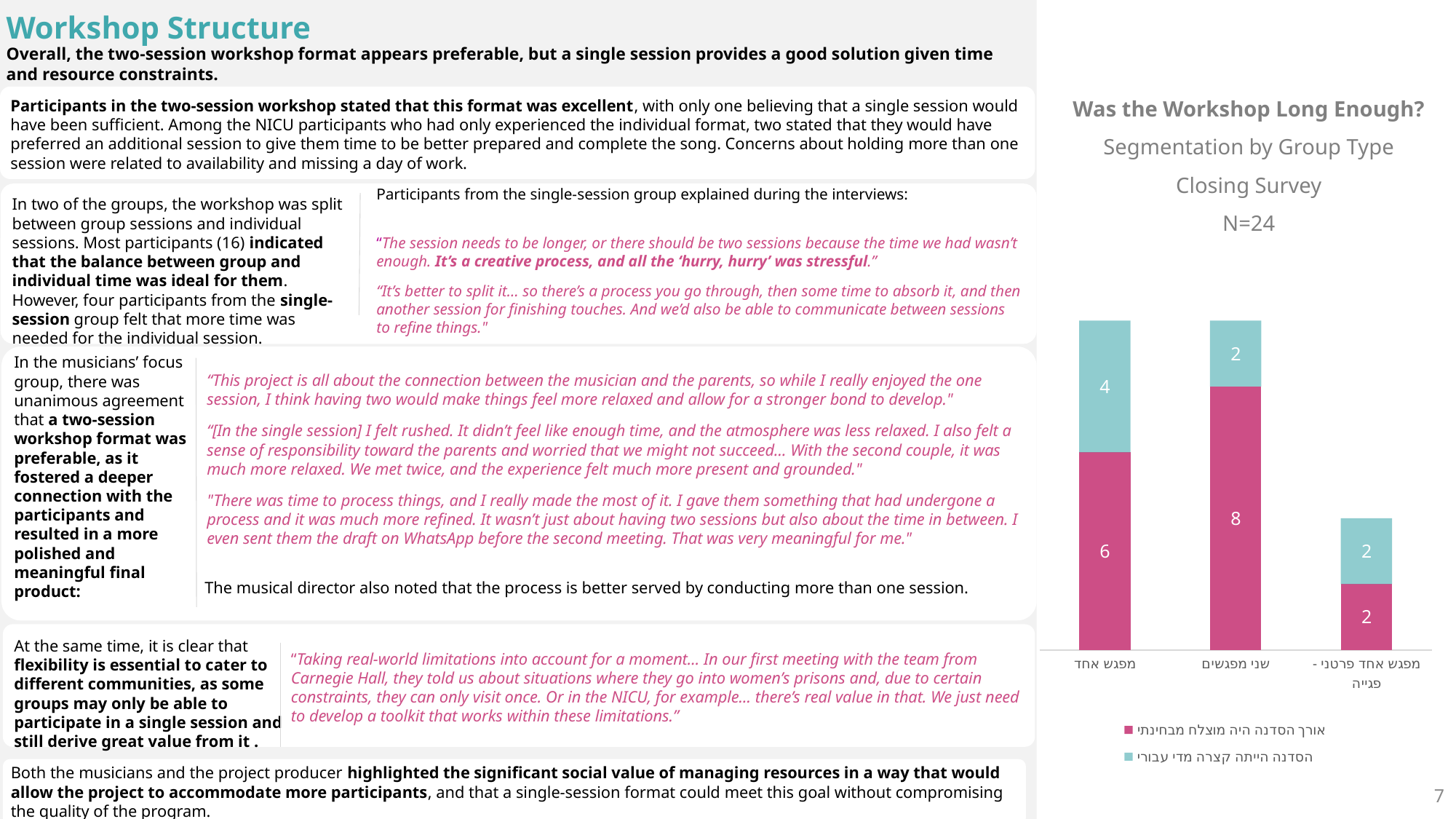
In the "Was the Workshop Long Enough?" chart, what is the value of the teal series (הסדנה הייתה קצרה מדי עבורי) for מפגש אחד? 4 What kind of chart is shown under the title "Was the Workshop Long Enough?"? Stacked bar chart In the "Was the Workshop Long Enough?" chart, which category has the highest value for the pink series (אורך הסדנה היה מוצלח מבחינתי)? שני מפגשים In the "Was the Workshop Long Enough?" chart, what is the total of the stacked bar for שני מפגשים? 10 How many categories are shown on the x axis of the "Was the Workshop Long Enough?" chart? 3 How many series does the legend of the "Was the Workshop Long Enough?" chart list? 2 In the "Was the Workshop Long Enough?" chart, what is the value of the pink series (אורך הסדנה היה מוצלח מבחינתי) for מפגש אחד? 6 In the "Was the Workshop Long Enough?" chart, which category has the lowest stacked total? מפגש אחד פרטני - פגייה In the "Was the Workshop Long Enough?" chart, what is the value of the pink series (אורך הסדנה היה מוצלח מבחינתי) for שני מפגשים? 8 In the "Was the Workshop Long Enough?" chart, what is the difference between the pink series values for שני מפגשים and מפגש אחד? 2 In the "Was the Workshop Long Enough?" chart, what is the value of the teal series (הסדנה הייתה קצרה מדי עבורי) for מפגש אחד פרטני - פגייה? 2 What sample size (N) is stated in the title of the "Was the Workshop Long Enough?" chart? N=24